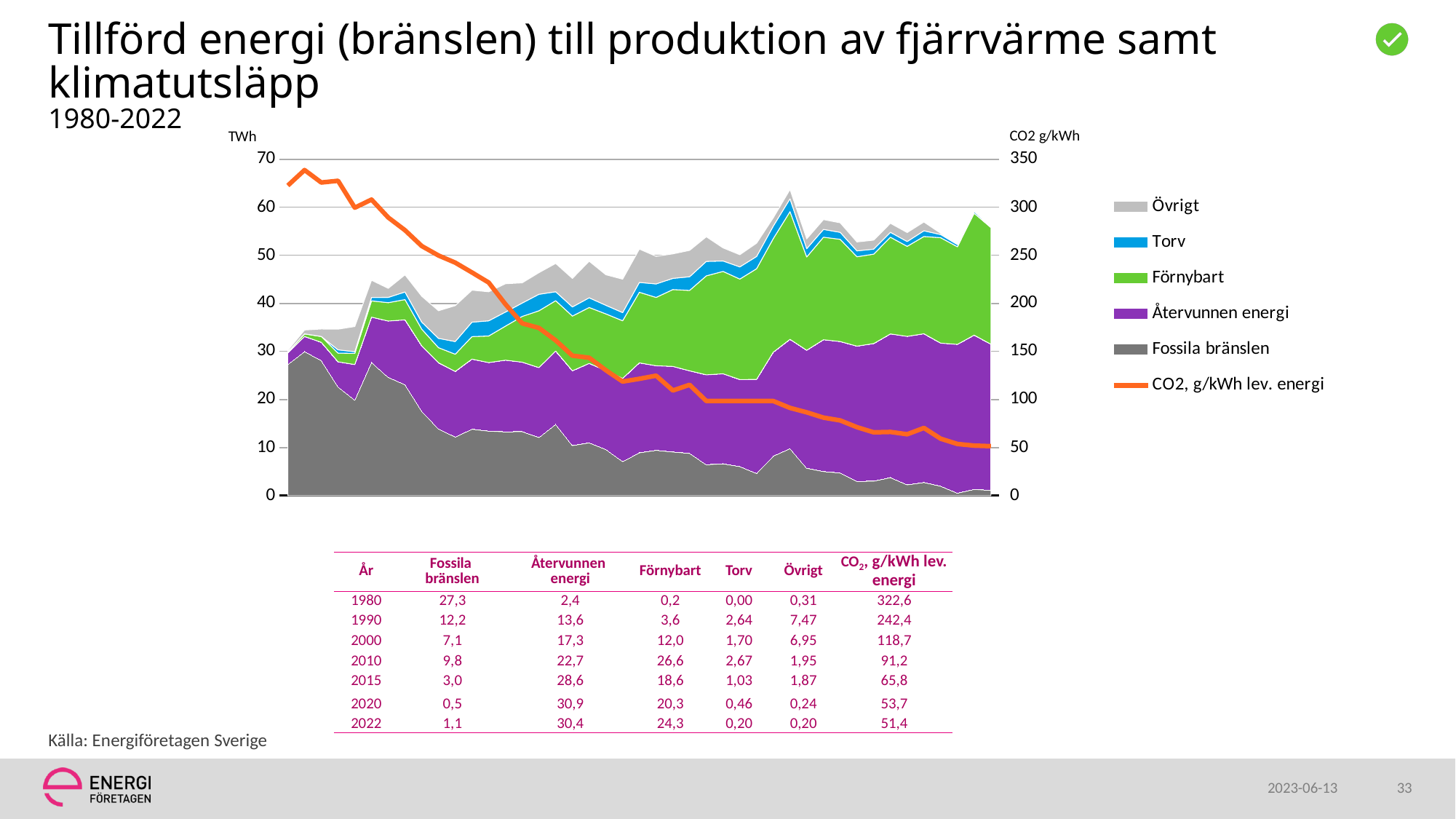
Does the CO2, g/kWh lev. energi line rise or fall from 1980 to 2022? Fall What unit is shown on the left vertical axis of the chart? TWh According to the table, what was the value for Fossila bränslen in 1980? 27,3 According to the table, what was the CO2, g/kWh lev. energi value in 2022? 51,4 What kind of chart is shown on the slide? A stacked area chart with a line Which year in the table has the lowest value for Fossila bränslen? 2020 Which year in the table has the highest value for Återvunnen energi? 2020 Which is larger in the table: Förnybart in 2010 or Förnybart in 2015? 2010 Is the CO2, g/kWh lev. energi value in 1980 greater or less than 300 on the right axis? greater What is the total TWh for 2022 summing Fossila bränslen, Återvunnen energi, Förnybart, Torv and Övrigt in the table? 56,2 How many series does the chart legend list? 6 By how much did CO2, g/kWh lev. energi decrease between 1980 and 2022 according to the table? 271,2